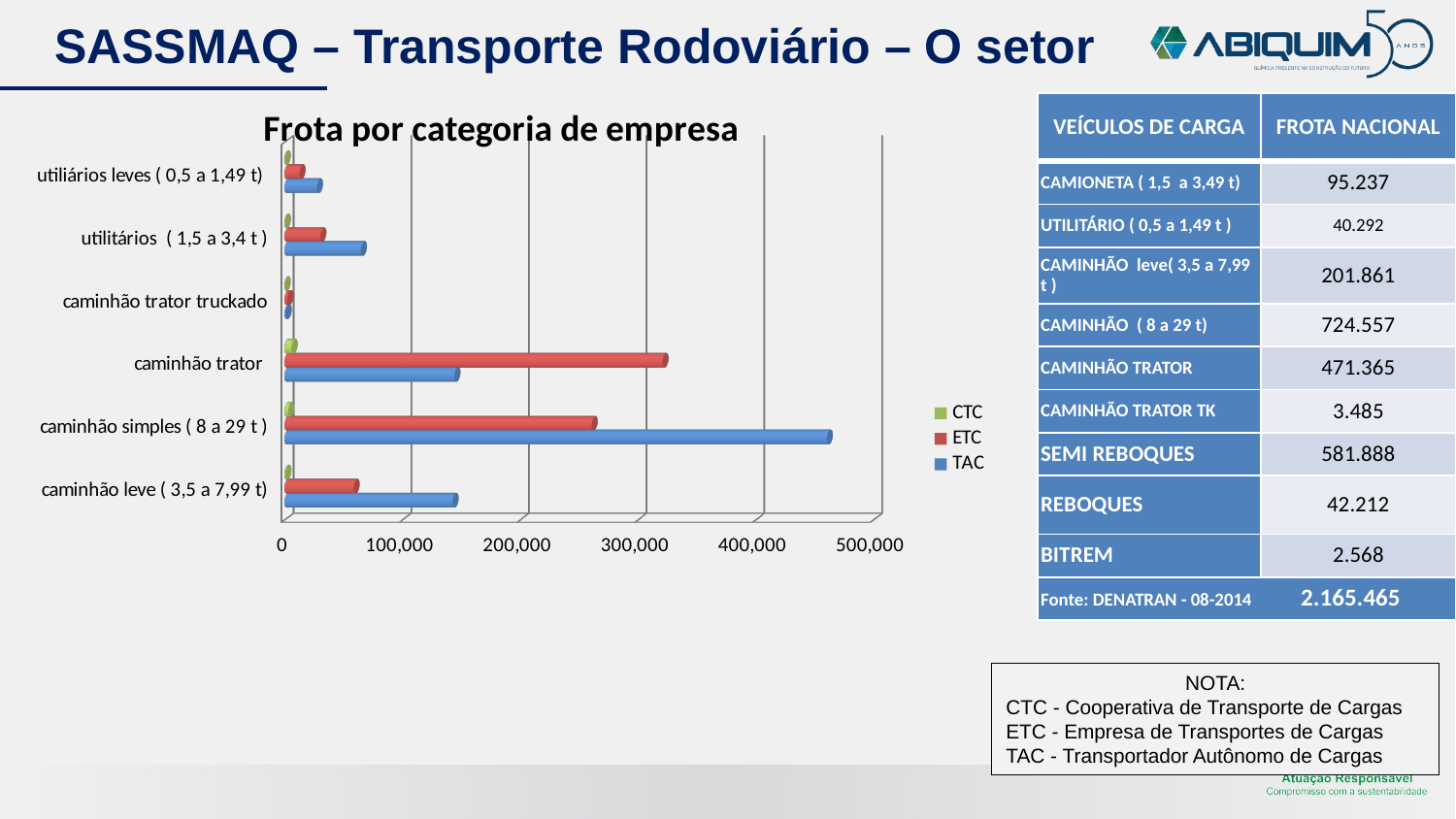
Which category has the highest TAC value? caminhão simples ( 8 a 29 t ) For caminhão simples ( 8 a 29 t ), which is larger, the ETC value or the TAC value? TAC Is the TAC value for caminhão simples ( 8 a 29 t ) greater or less than 400,000? greater Is the ETC value for caminhão leve ( 3,5 a 7,99 t ) greater or less than 100,000? less Which category has the highest ETC value? caminhão trator Is the ETC value for caminhão trator greater or less than 300,000? greater What type of chart is shown on the slide? bar chart How many series does the chart legend list? 3 What is the title of the chart? Frota por categoria de empresa How many categories are shown on the chart's vertical axis? 6 For caminhão trator, which is larger, the ETC value or the TAC value? ETC